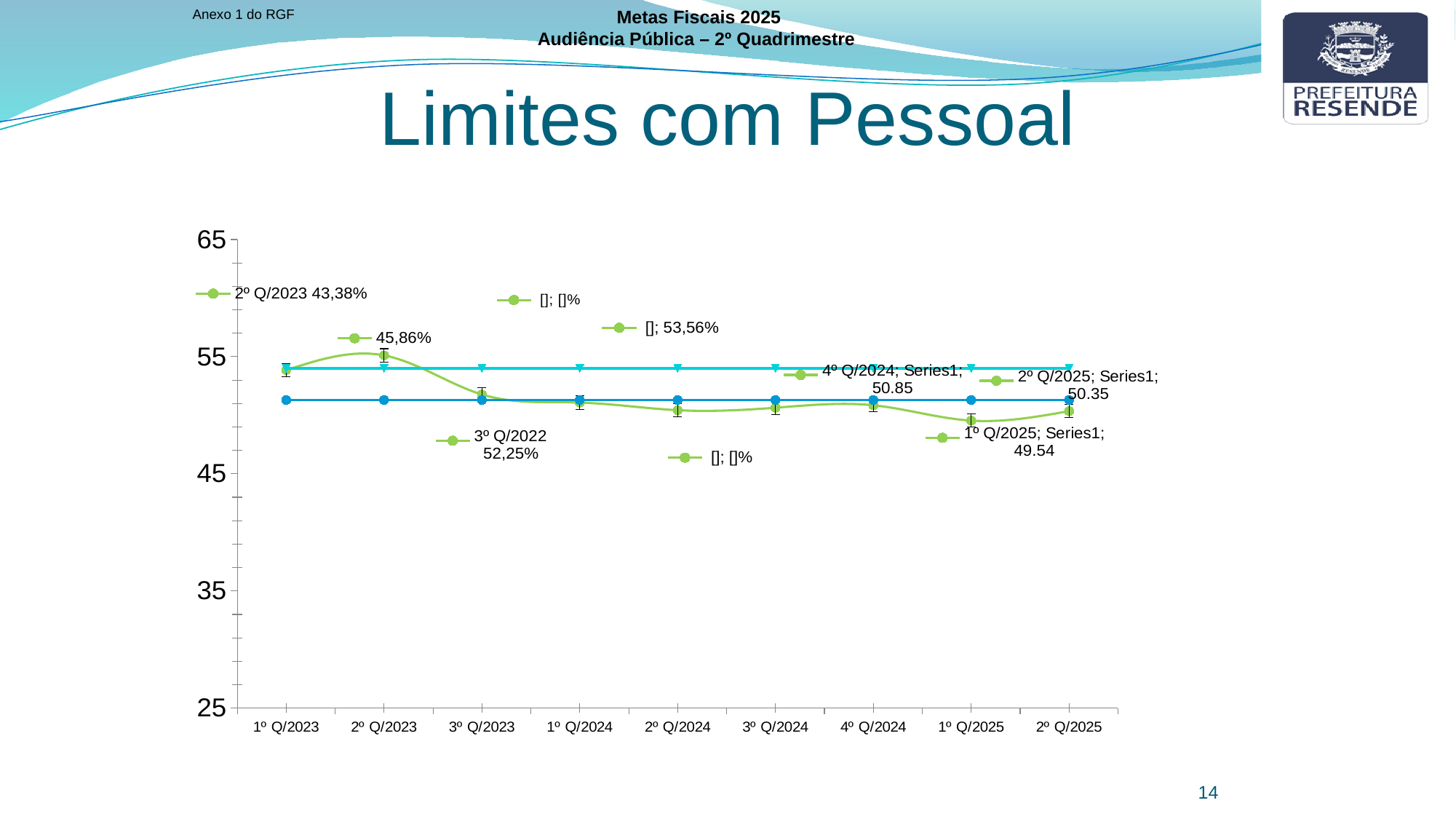
What is the value of Series1 for 1º Q/2025? 49.54 What is the value of Series1 for 2º Q/2025? 50.35 What kind of chart is shown on the slide? line chart What is the title of the chart? Limites com Pessoal How many categories are shown on the x axis of the chart? 9 What is the lowest value shown on the y axis of the chart? 25 What is the difference between the Series1 values for 2º Q/2025 and 1º Q/2025? 0.81 Does the Series1 line rise or fall from 4º Q/2024 to 1º Q/2025? fall Which is larger, the Series1 value for 4º Q/2024 or for 2º Q/2025? 4º Q/2024 What is the value of Series1 for 4º Q/2024? 50.85 Is the value of the green line for 2º Q/2023 greater or less than 45? greater What is the difference between the Series1 values for 4º Q/2024 and 1º Q/2025? 1.31